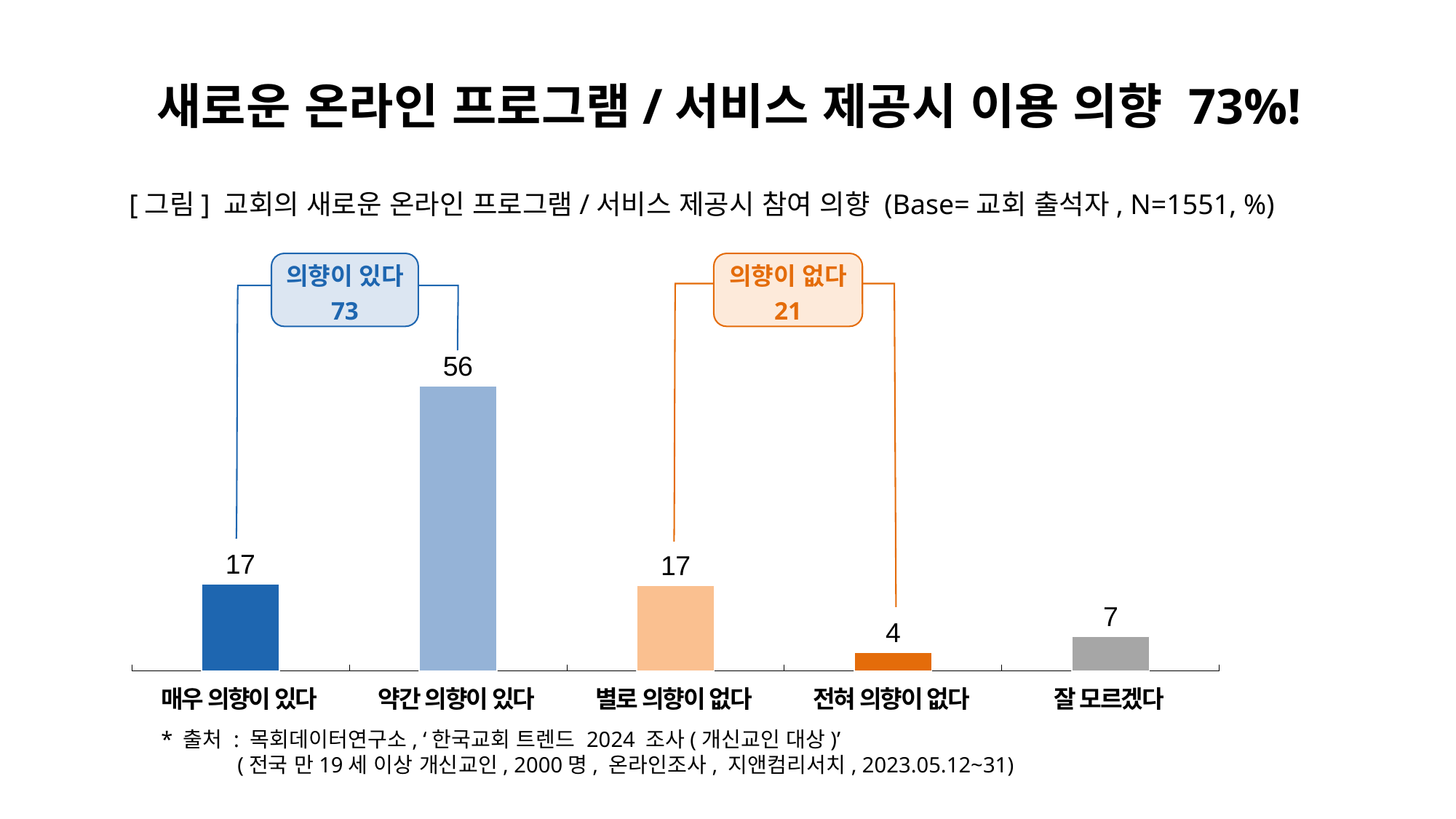
What combined value is shown in the 의향이 있다 bracket label? 73 What combined value is shown in the 의향이 없다 bracket label? 21 Which category has the lowest value? 전혀 의향이 없다 Which category has the highest value? 약간 의향이 있다 What is the value for 잘 모르겠다? 7 How many categories are shown on the x axis? 5 What is the difference between the values for 약간 의향이 있다 and 매우 의향이 있다? 39 Which is larger, the value for 잘 모르겠다 or the value for 전혀 의향이 없다? 잘 모르겠다 What is the value for 매우 의향이 있다? 17 What kind of chart is shown on the slide? bar chart What is the value for 전혀 의향이 없다? 4 What is the value for 약간 의향이 있다? 56